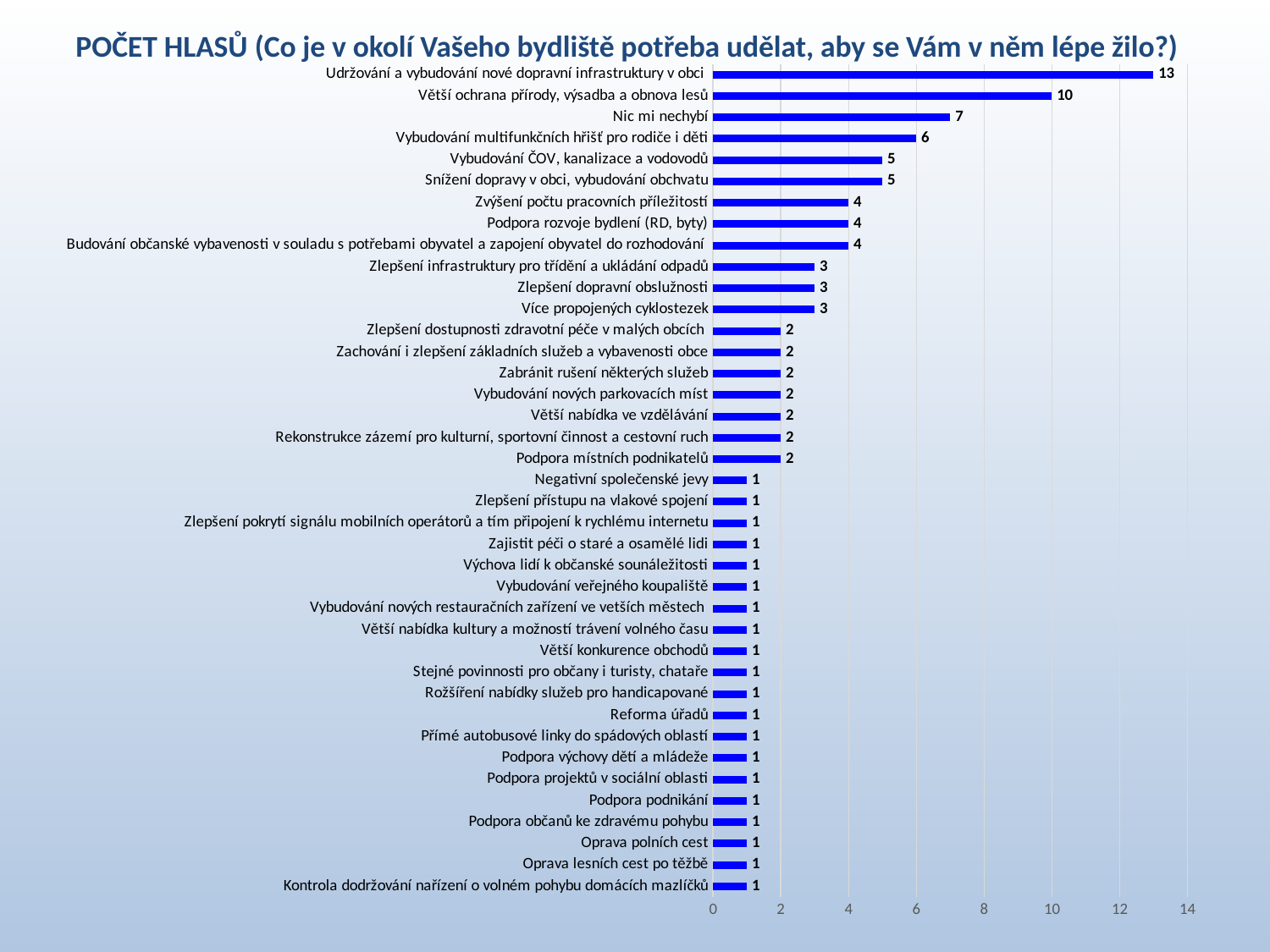
What is the value for "Více propojených cyklostezek"? 3 What is the title of the chart? POČET HLASŮ (Co je v okolí Vašeho bydliště potřeba udělat, aby se Vám v něm lépe žilo?) How many votes did "Udržování a vybudování nové dopravní infrastruktury v obci" receive? 13 What is the difference in votes between "Udržování a vybudování nové dopravní infrastruktury v obci" and "Větší ochrana přírody, výsadba a obnova lesů"? 3 How many votes are shown for "Nic mi nechybí"? 7 What type of chart is shown on the slide? bar chart Which has more votes: "Nic mi nechybí" or "Vybudování multifunkčních hřišť pro rodiče i děti"? Nic mi nechybí Is the value for "Větší ochrana přírody, výsadba a obnova lesů" greater or less than 8? greater Which category has the highest number of votes? Udržování a vybudování nové dopravní infrastruktury v obci What is the value for "Vybudování ČOV, kanalizace a vodovodů"? 5 What is the value for "Větší ochrana přírody, výsadba a obnova lesů"? 10 How many categories are plotted in the chart? 39